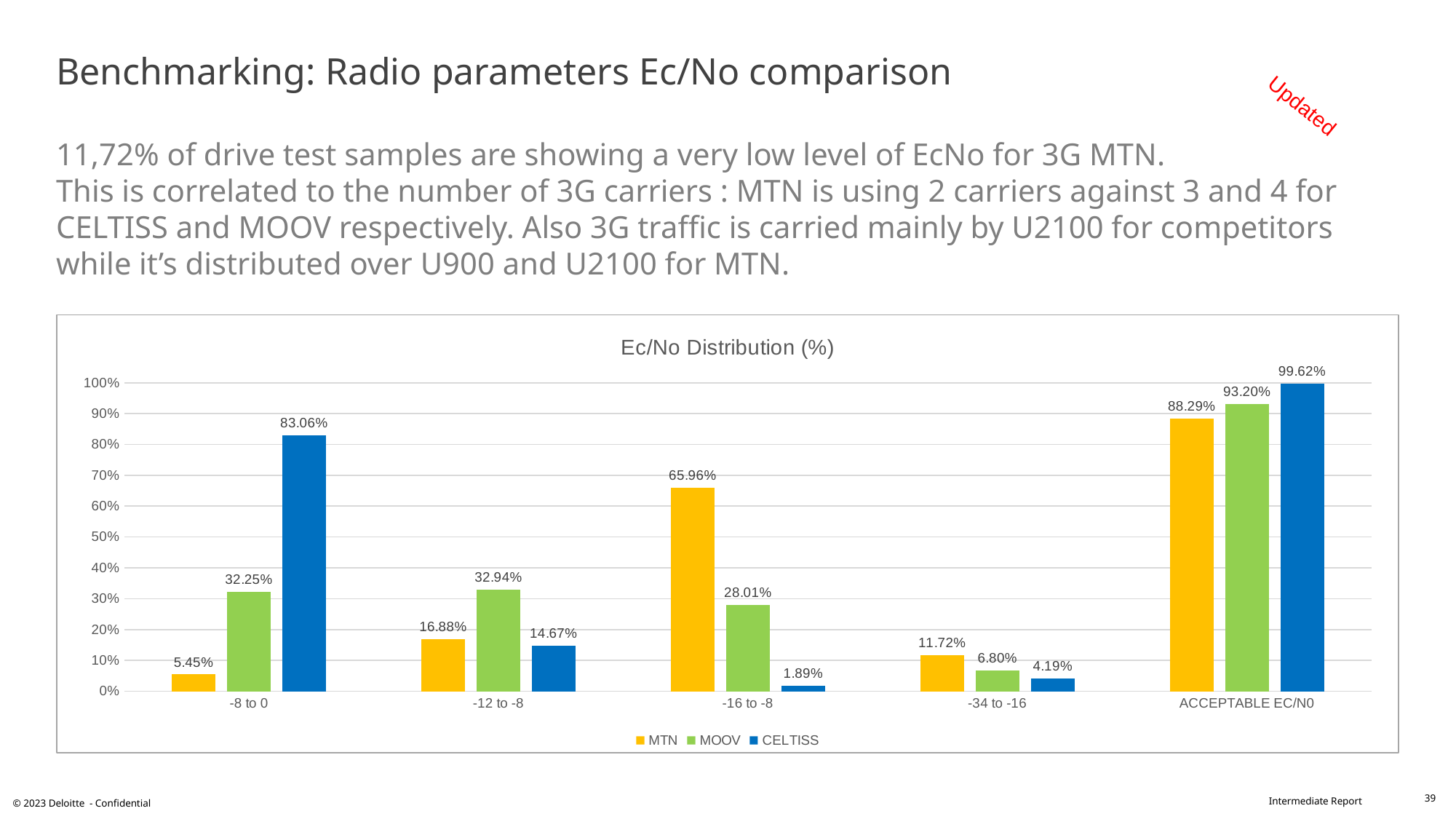
How many series does the legend list? 3 Which series has the highest value in the ACCEPTABLE EC/N0 category? CELTISS What is the value for MTN in the -16 to -8 category? 65.96% What is the value for MOOV in the ACCEPTABLE EC/N0 category? 93.20% Is the value for MOOV in the -8 to 0 category greater or less than 30%? greater What is the value for CELTISS in the -8 to 0 category? 83.06% What kind of chart is shown on the slide? Bar chart Which series has the lowest value in the -16 to -8 category? CELTISS What is the title of the chart? Ec/No Distribution (%) How many categories are shown on the x axis? 5 Which is larger in the -12 to -8 category, the MTN value or the CELTISS value? MTN What is the difference between the MTN and MOOV values in the -34 to -16 category? 4.92%